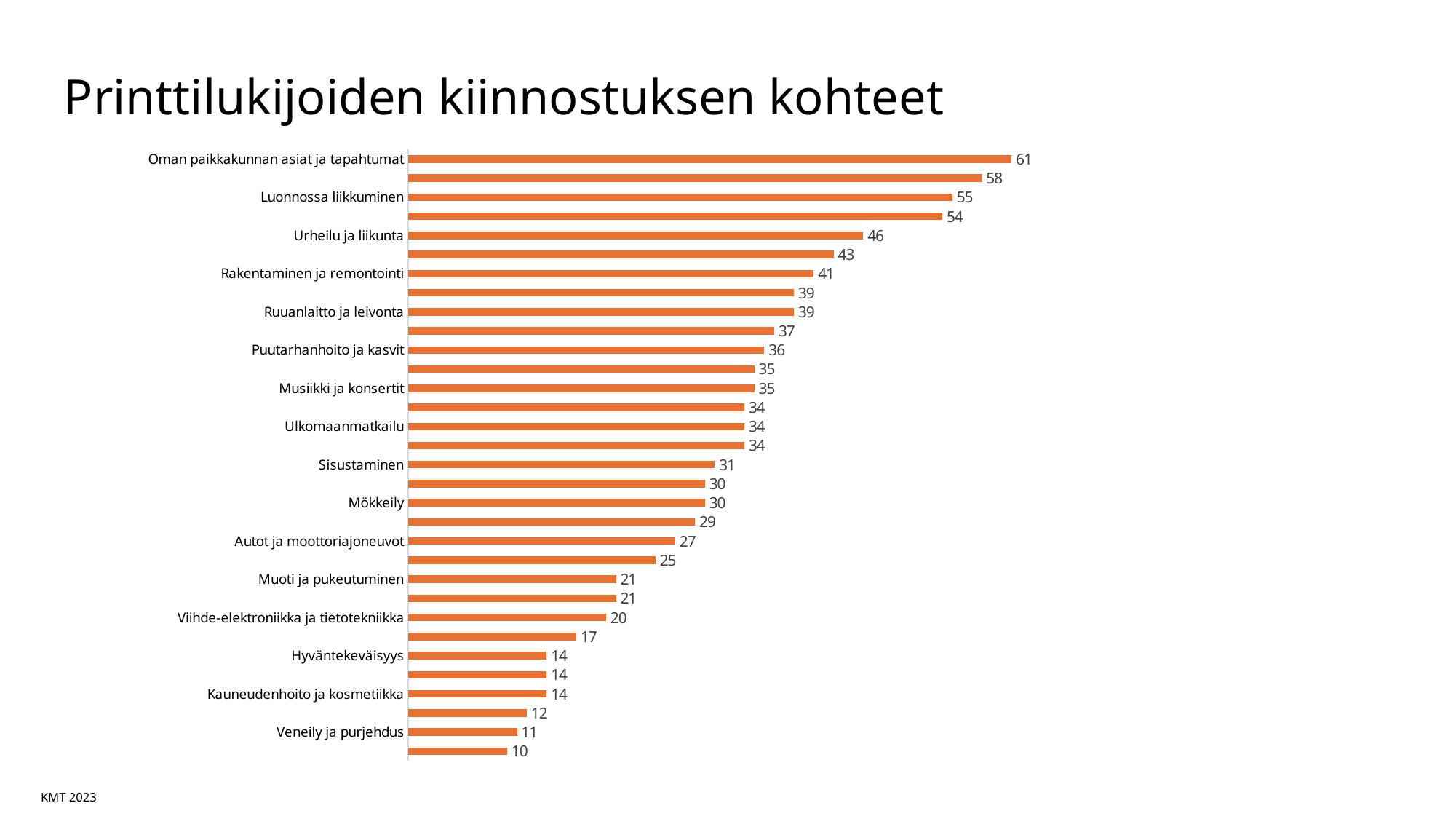
What is the value for Ulkomaanmatkailu? 34 Do the bar values increase or decrease from the top of the chart to the bottom? Decrease What is the value for Luonnossa liikkuminen? 55 What is the title of the chart? Printtilukijoiden kiinnostuksen kohteet What kind of chart is shown on the slide? Bar chart What is the value of the shortest bar in the chart? 10 How many bars are plotted in the chart? 32 What is the value for Oman paikkakunnan asiat ja tapahtumat? 61 Which labelled category has the highest value? Oman paikkakunnan asiat ja tapahtumat What is the value for Veneily ja purjehdus? 11 What is the difference between the values for Luonnossa liikkuminen and Urheilu ja liikunta? 9 Which is larger, the value for Rakentaminen ja remontointi or the value for Ruuanlaitto ja leivonta? Rakentaminen ja remontointi